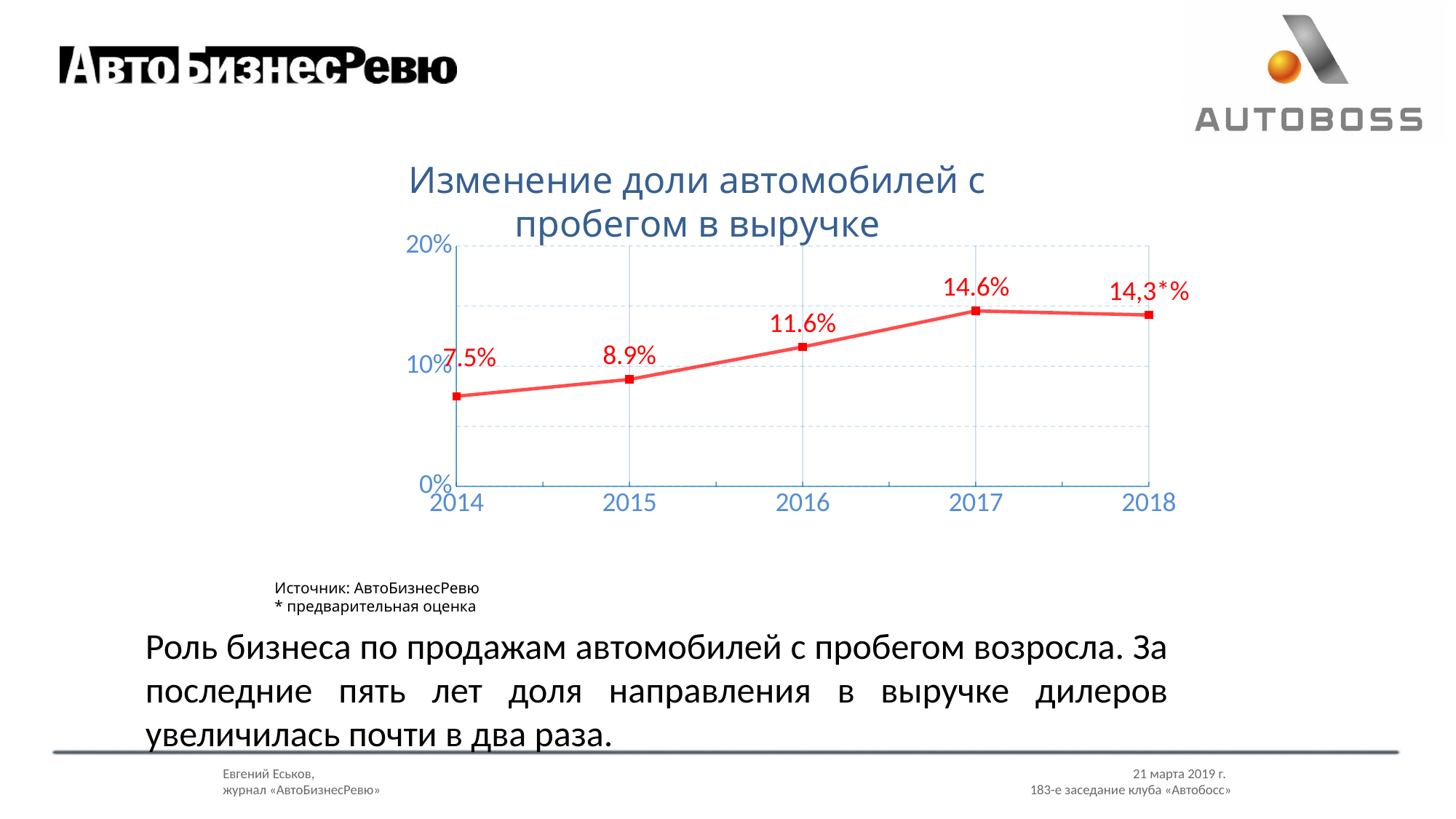
What is the value for 2016? 11.6% Which year has the lowest value? 2014 What is the difference between the values for 2017 and 2014? 7.1 percentage points What is the value shown for 2018? 14,3*% Which year has the highest value? 2017 What is the difference between the values for 2016 and 2015? 2.7 percentage points How many years are plotted on the chart? 5 Which is larger, the value for 2015 or the value for 2016? 2016 What is the value for 2017? 14.6% Is the value for 2015 greater or less than 10%? less What is the value for 2014? 7.5% What kind of chart is shown on the slide? line chart